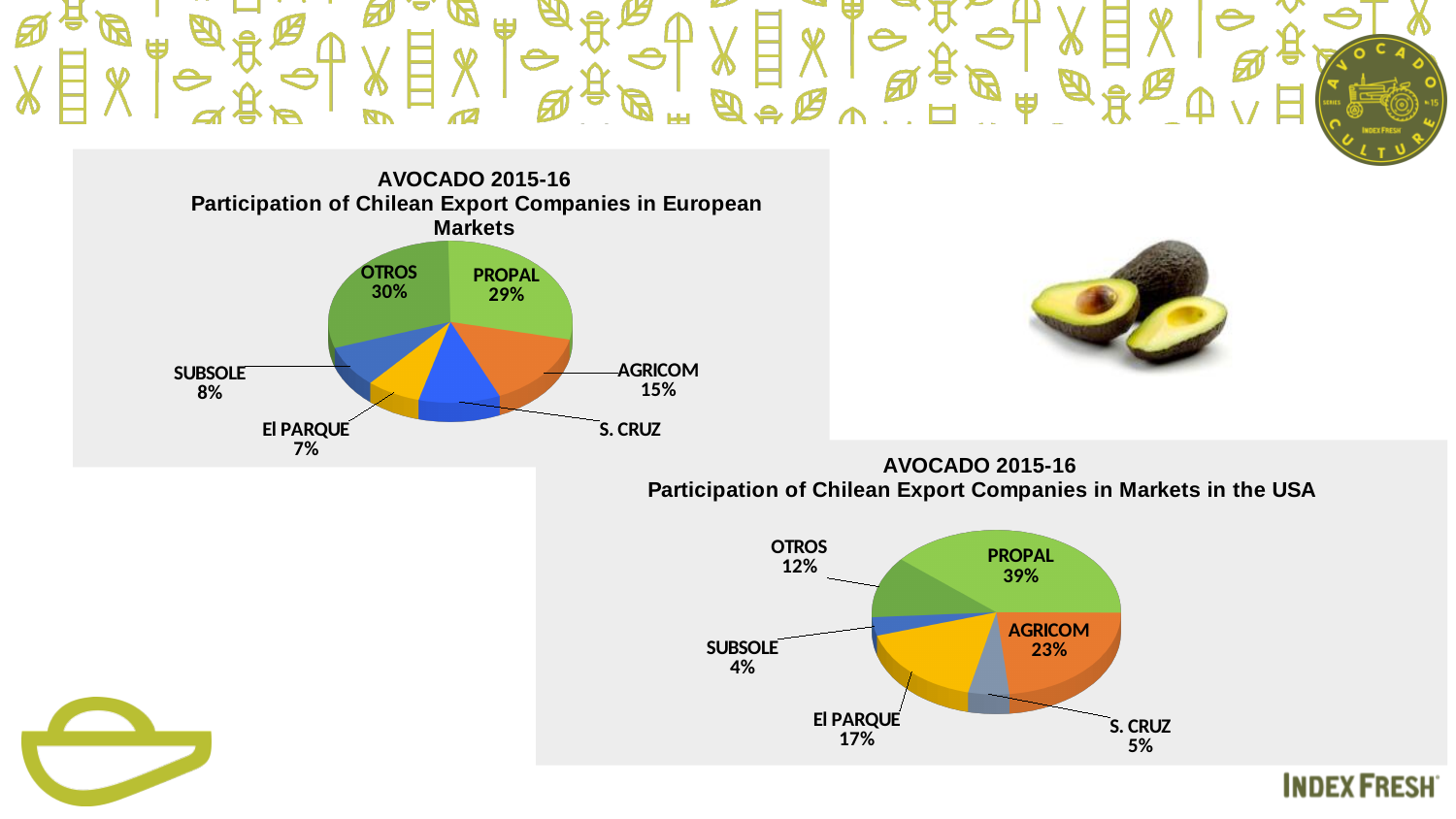
In the European Markets pie chart, what is the difference between the OTROS share and the SUBSOLE share? 22% How many slices does the Markets in the USA pie chart have? 6 In the Markets in the USA pie chart, which company has the smallest share? SUBSOLE In the European Markets pie chart, what share does PROPAL hold? 29% What type of chart is used to show the participation of Chilean export companies in European markets? Pie chart In the Markets in the USA pie chart, what share does PROPAL hold? 39% In the Markets in the USA pie chart, what share does El PARQUE hold? 17% In the Markets in the USA pie chart, which is larger, the share of AGRICOM or the share of OTROS? AGRICOM In the European Markets pie chart, which labelled company has the smallest share? El PARQUE In the Markets in the USA pie chart, what is the difference between the PROPAL share and the AGRICOM share? 16% In the European Markets pie chart, what share does AGRICOM hold? 15% In the Markets in the USA pie chart, which company has the largest share? PROPAL